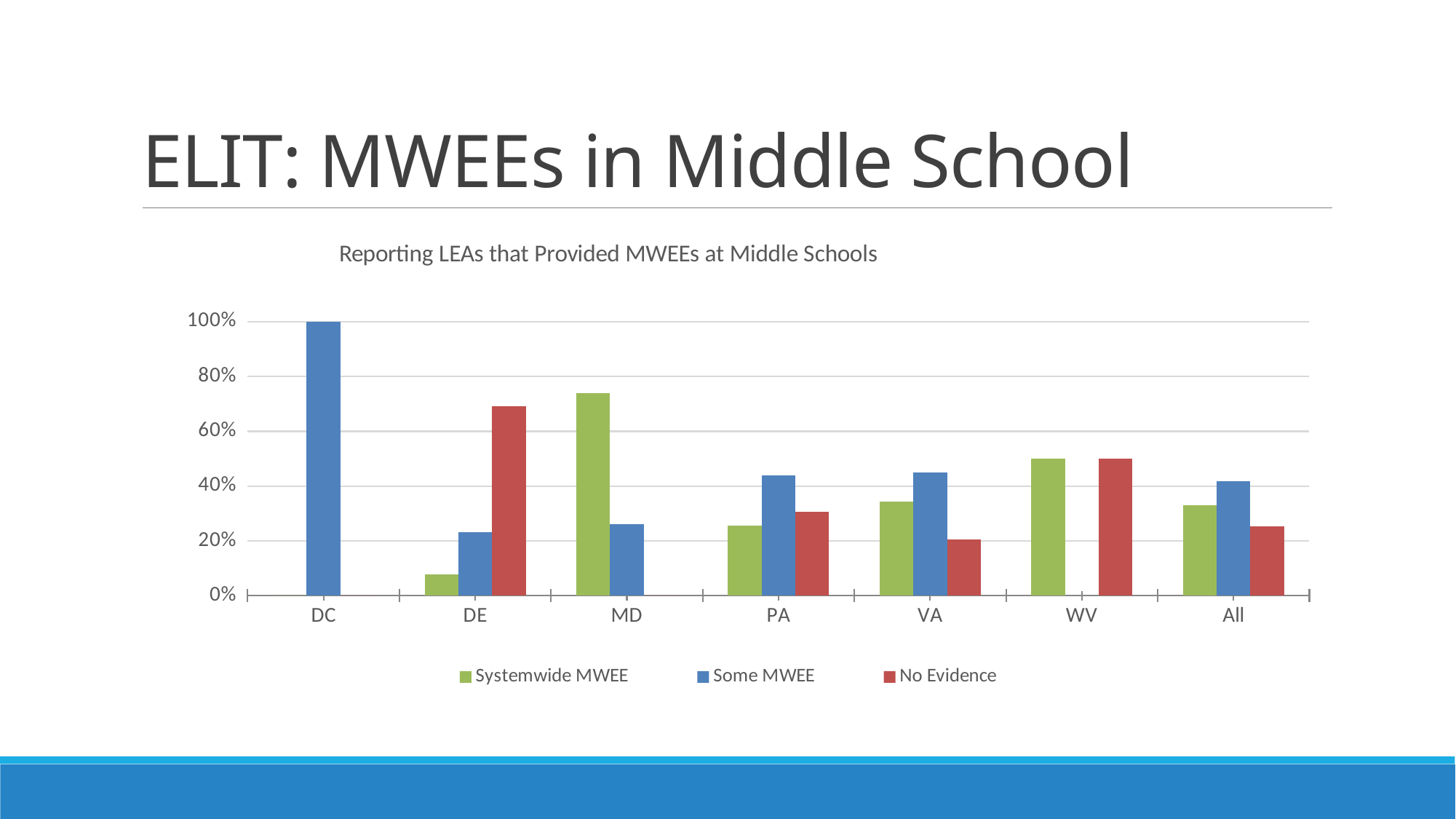
What kind of chart is shown on the slide? Bar chart For DE, which is larger: Some MWEE or No Evidence? No Evidence Is the Systemwide MWEE value for MD greater or less than 60%? greater How many series does the legend list? 3 Which category has the highest Some MWEE value? DC Is the Systemwide MWEE value for DE greater or less than 20%? less How many categories are shown on the x axis? 7 Is the Some MWEE value for PA greater or less than 40%? greater Which category has the highest Systemwide MWEE value? MD For MD, which is larger: Systemwide MWEE or Some MWEE? Systemwide MWEE What is the value of Some MWEE for DC? 100%